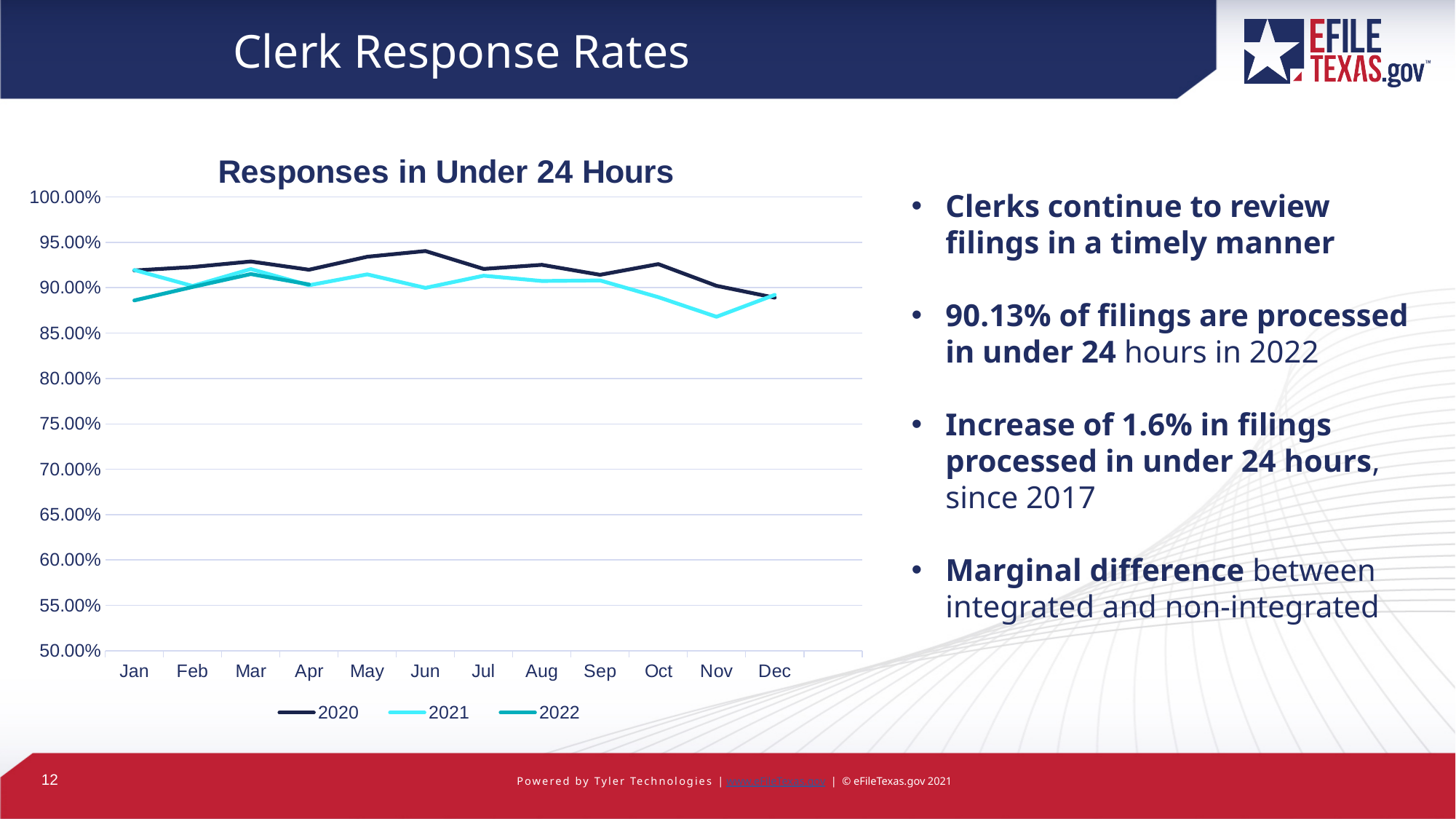
Is the 2020 value for Jun greater or less than 90.00%? greater Is the 2021 value for Nov greater or less than 90.00%? less Which years are listed in the chart legend? 2020, 2021, 2022 Is the 2022 value for Jan greater or less than 90.00%? less Does the 2021 line rise or fall from Sep to Nov? Fall In Oct, which series has the higher value, 2020 or 2021? 2020 In which month does the 2020 line reach its highest point? Jun What is the title of the chart? Responses in Under 24 Hours How many months are shown on the x axis of the chart? 12 How many series does the chart legend list? 3 In which month does the 2021 line reach its lowest point? Nov What kind of chart is shown on the slide? Line chart